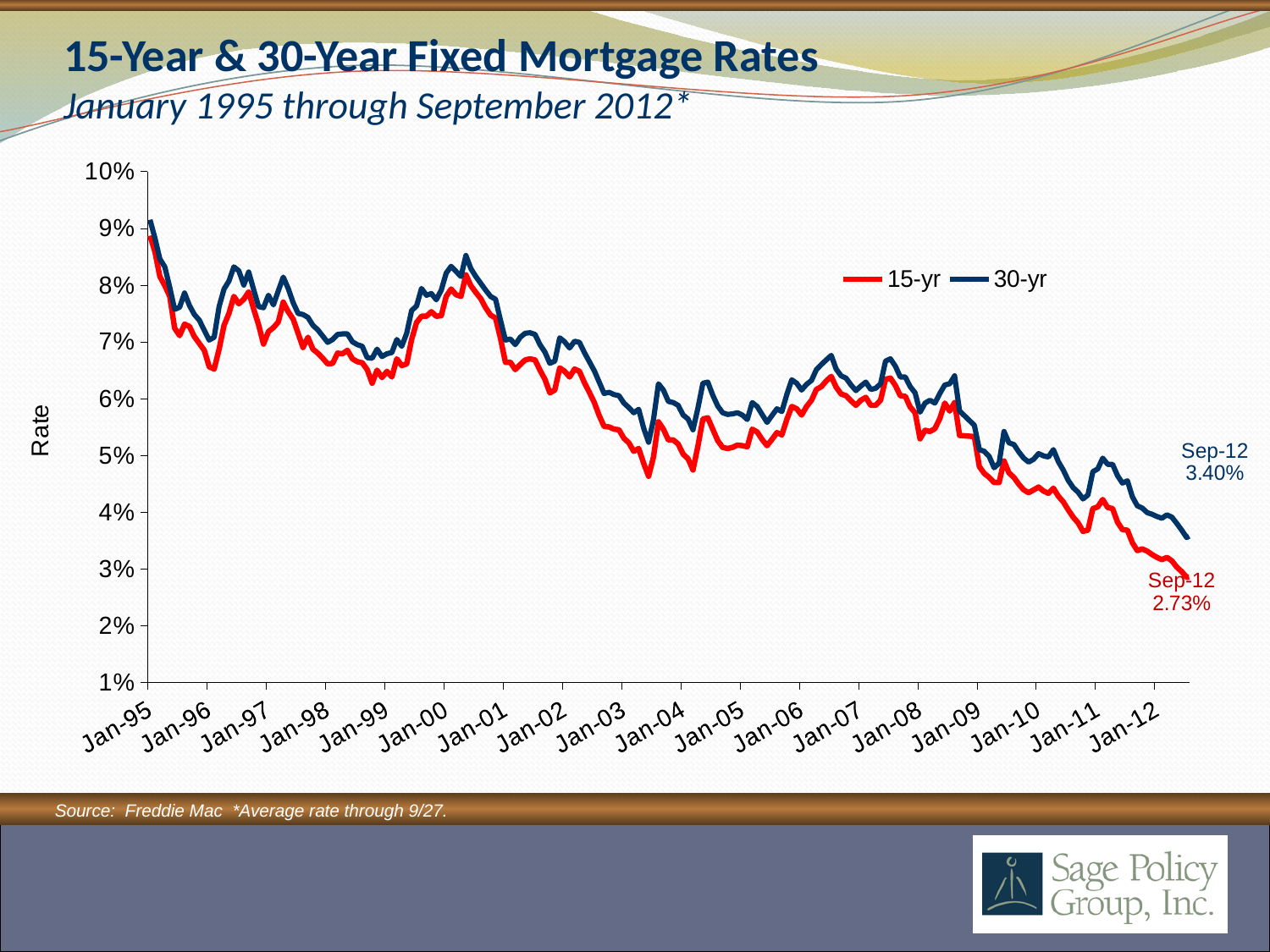
In Sep-12, which series has the higher rate, 15-yr or 30-yr? 30-yr What is the difference between the 30-yr and 15-yr rates labelled for Sep-12? 0.67 percentage points Is the 15-yr rate at Jan-95 greater or less than 8%? greater What kind of chart is shown on the slide? line chart What is the 30-yr fixed mortgage rate shown for Sep-12? 3.40% Is the 15-yr rate at Jan-03 greater or less than 6%? less Is the 30-yr rate at Jan-10 greater or less than 4%? greater What is the 15-yr fixed mortgage rate shown for Sep-12? 2.73% What colour is the 15-yr line in the chart? red Overall, do the mortgage rates rise or fall from Jan-95 to Sep-12? fall How many series does the legend list? 2